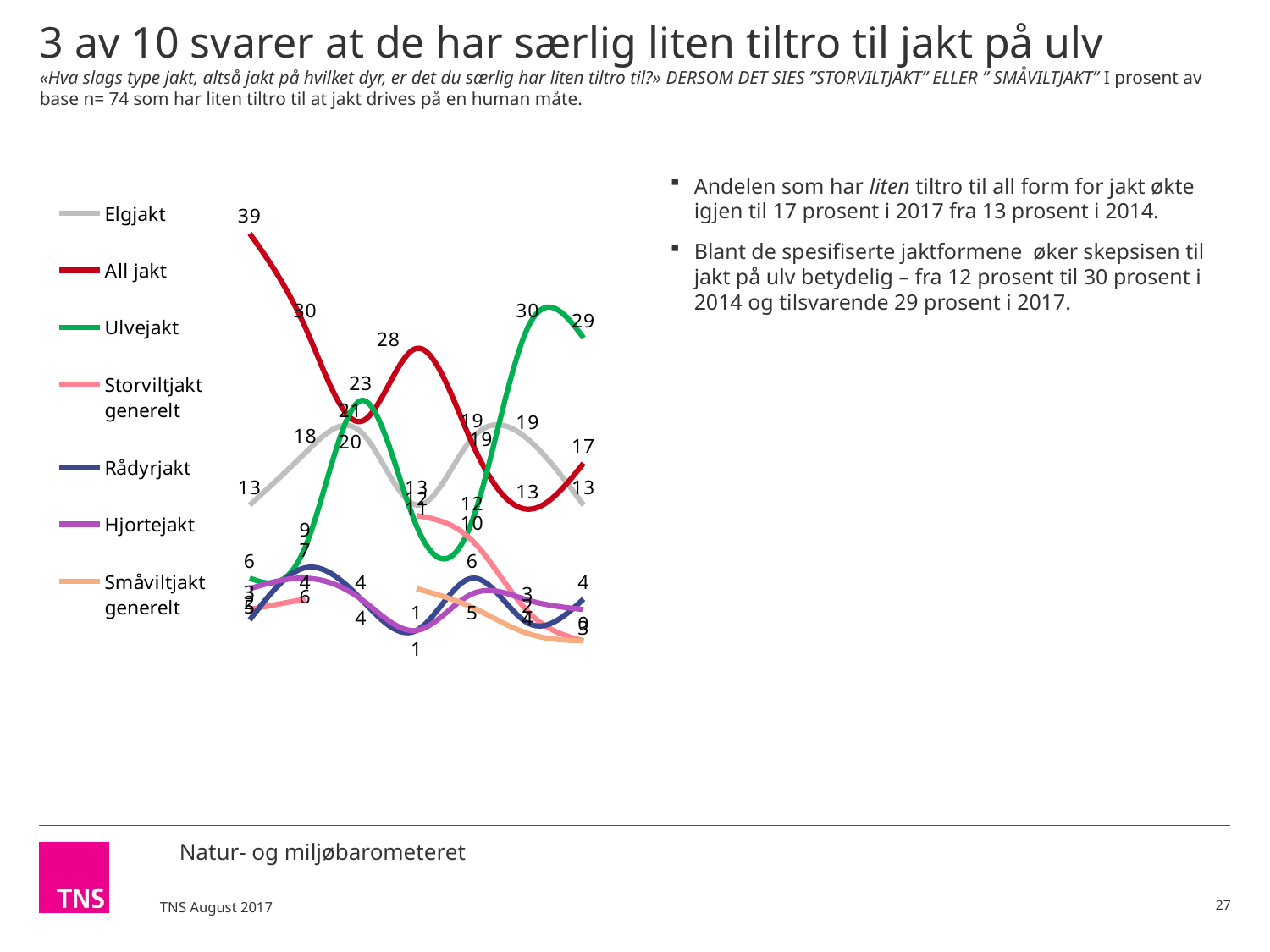
At the rightmost point, which is larger: Ulvejakt or All jakt? Ulvejakt Does the Ulvejakt series overall rise or fall from its leftmost point to its rightmost point? rise Does the All jakt series overall rise or fall from its leftmost point to its rightmost point? fall What is the value of the Ulvejakt series at its rightmost point? 29 What kind of chart is shown on the slide? line chart At the rightmost point, what is the difference between Ulvejakt (29) and All jakt (17)? 12 What is the highest value shown anywhere on the chart? 39 What is the value of the All jakt series at its leftmost point? 39 How many series does the legend list? 7 Which series is drawn in green? Ulvejakt What is the highest value reached by the Ulvejakt series? 30 What is the value of the All jakt series at its rightmost point? 17